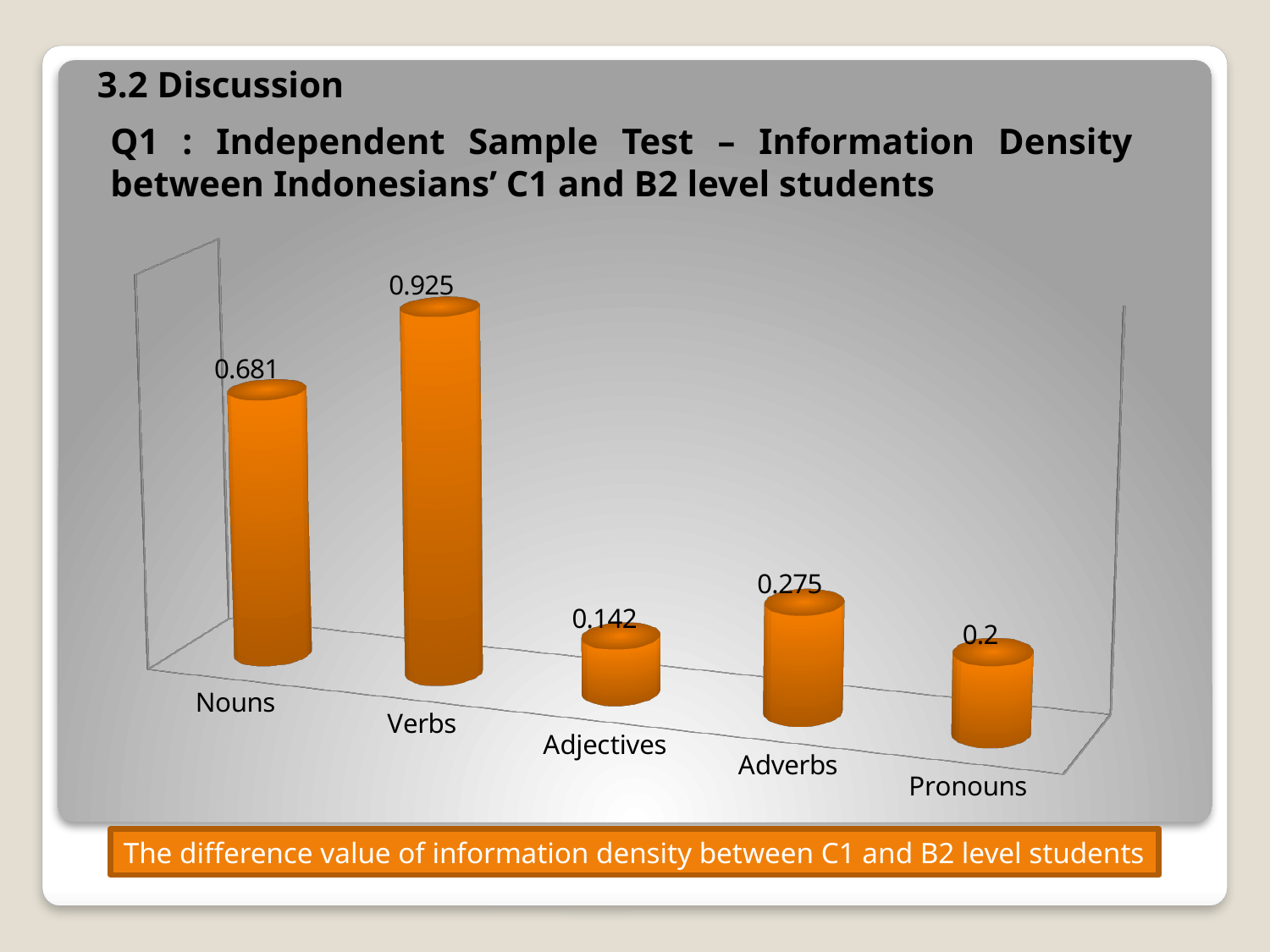
What is the value for Nouns? 0.681 What is the value for Verbs? 0.925 Which category has the highest value? Verbs Which category has the lowest value? Adjectives How many categories are shown in the chart? 5 What kind of chart is shown on the slide? Bar chart What is the value for Pronouns? 0.2 What is the caption shown below the chart? The difference value of information density between C1 and B2 level students What is the value for Adverbs? 0.275 Which is larger, the value for Adverbs or the value for Pronouns? Adverbs What is the value for Adjectives? 0.142 What is the difference between the values for Verbs and Nouns? 0.244